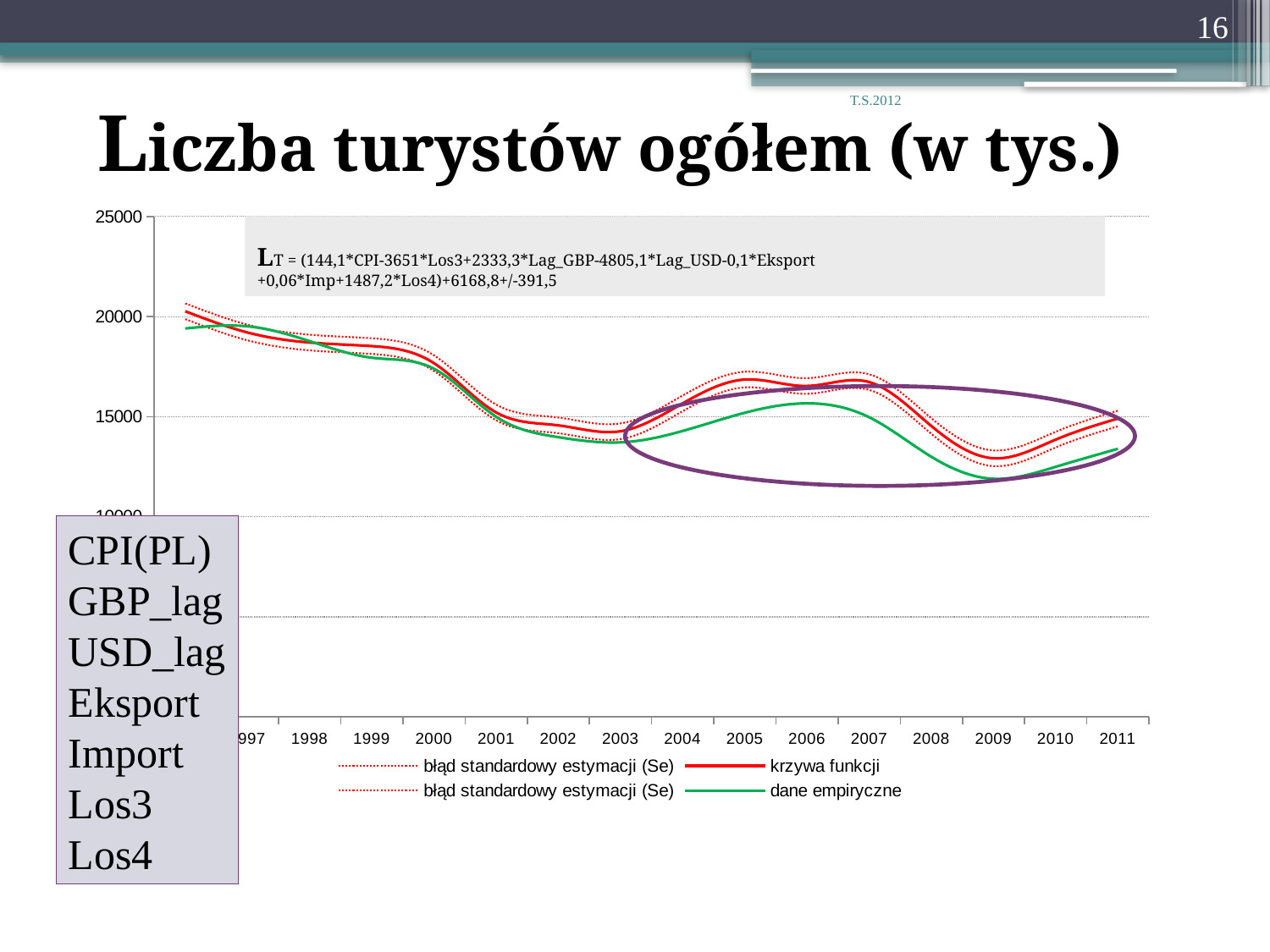
What is the title of the chart? Liczba turystów ogółem (w tys.) In which year does the 'dane empiryczne' series reach its lowest value? 2009 Is the value of 'krzywa funkcji' in 2006 greater or less than 15000? greater How many series does the chart legend list? 4 Which colour is used for the 'dane empiryczne' series? green What kind of chart is shown on the slide? line chart Is the value of 'krzywa funkcji' in 1998 greater or less than 20000? less Is the value of 'dane empiryczne' in 2009 greater or less than 15000? less What is the last year shown on the x axis? 2011 Does the 'dane empiryczne' series rise or fall between 1997 and 2003? fall In 2006, which series is higher: 'krzywa funkcji' or 'dane empiryczne'? krzywa funkcji